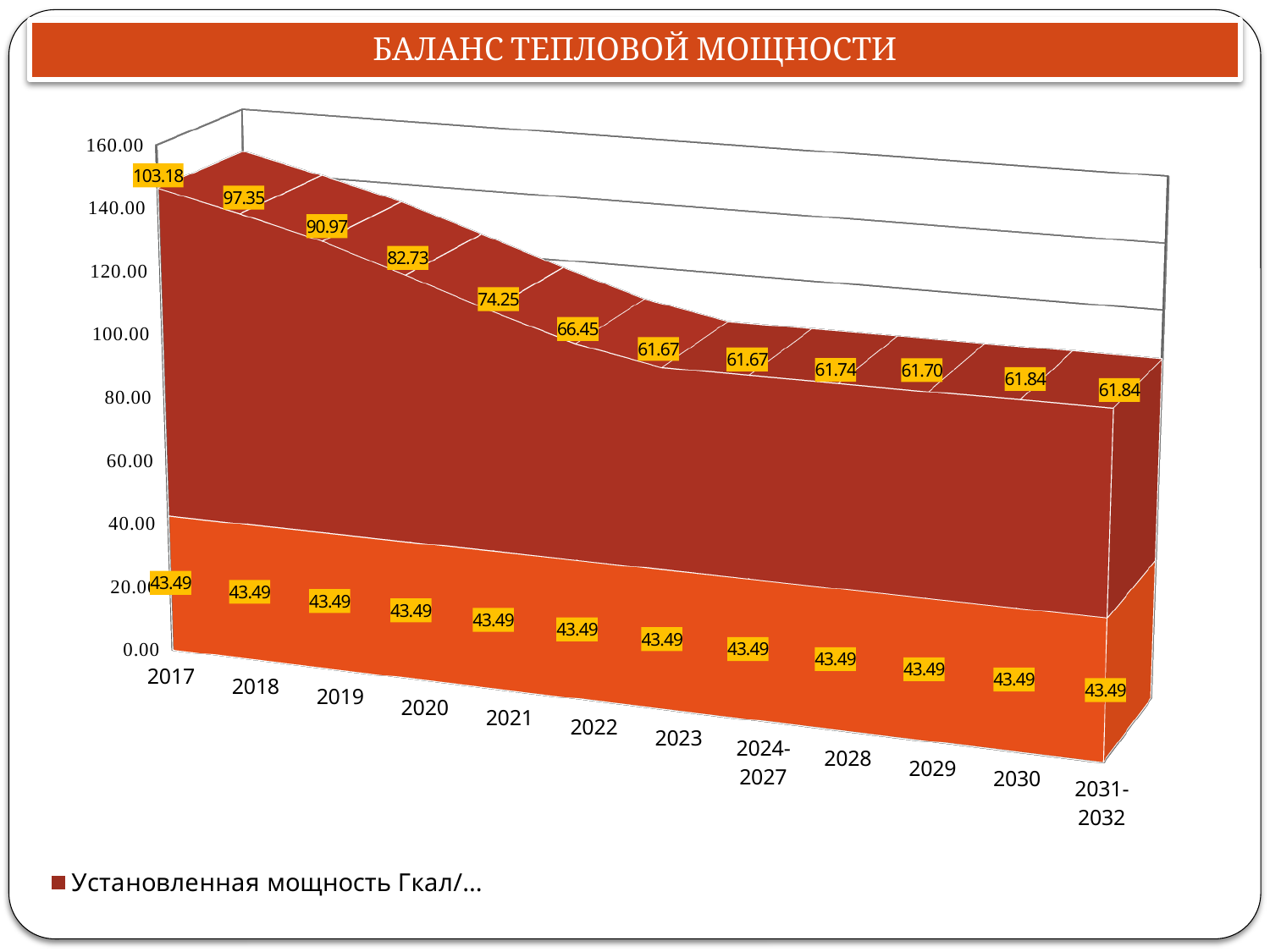
What is the difference between the dark red series values for 2017 and 2018? 5.83 Among the years 2017 to 2022, which year has the lowest value in the dark red (upper) series? 2022 What is the value of the dark red (upper) series for 2017? 103.18 Does the dark red (upper) series rise or fall from 2017 to 2023? Fall Which year has the highest value in the dark red (upper) series? 2017 What is the difference between the dark red series values for 2020 and 2021? 8.48 What is the combined total of the two stacked series for 2017? 146.67 Which has the larger dark red series value, 2019 or 2022? 2019 What is the value of the dark red (upper) series for 2021? 74.25 What is the value of the orange (lower) series for 2019? 43.49 What kind of chart is shown on the slide? Area chart How many categories are shown on the x axis? 12